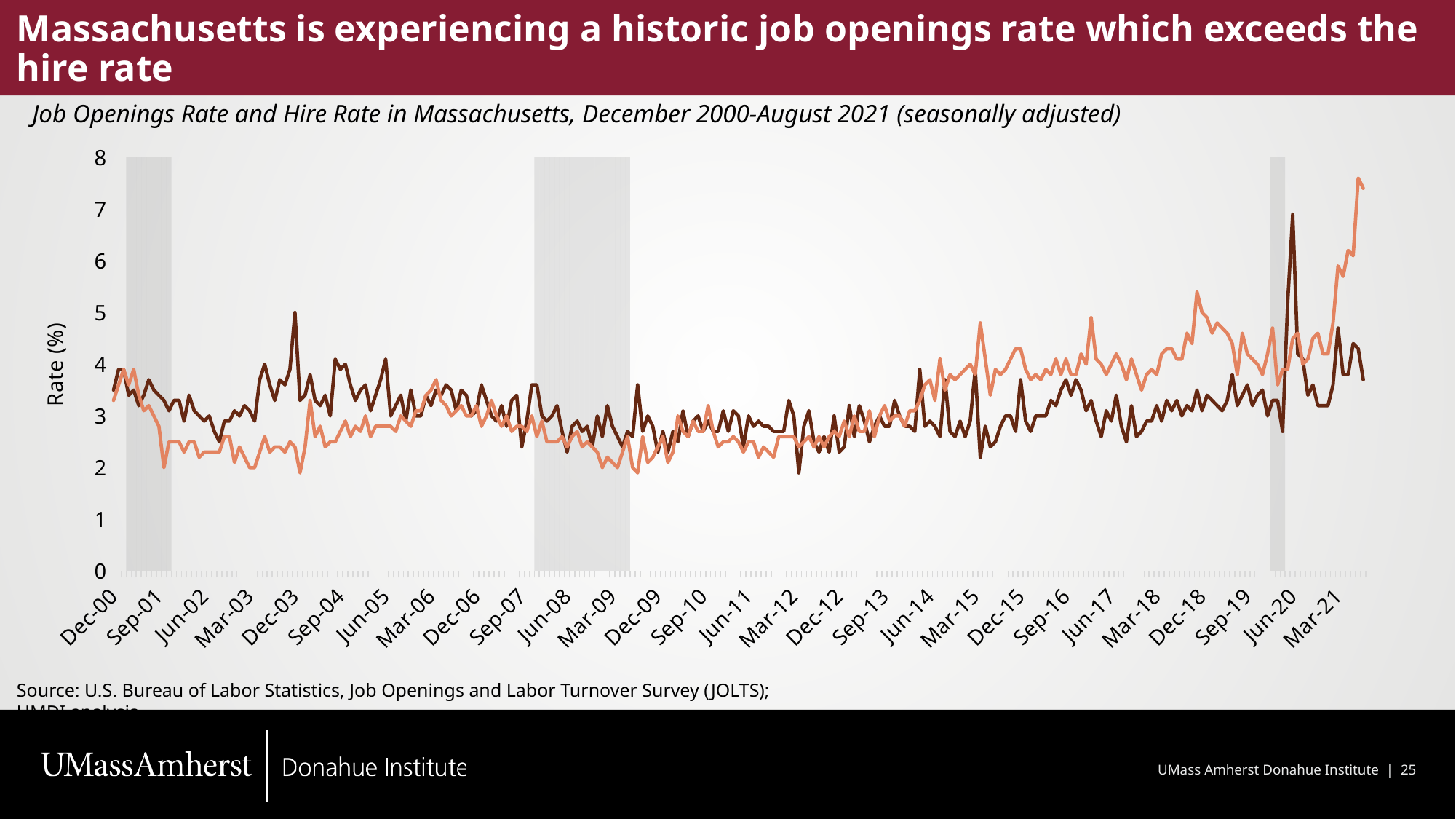
Is the peak value of the orange line, reached near the right end of the chart, greater or less than 7? greater What kind of chart is shown on the slide? Line chart What is the label on the vertical axis of the chart? Rate (%) What is the highest value shown on the vertical axis? 8 Which line is higher at the right end of the chart, the orange line or the dark brown line? The orange line What is the first date label on the horizontal axis? Dec-00 Is the value of the orange line at Dec-00 greater or less than 4? less Is the spike in the dark brown line around Jun-20 greater or less than 6? greater What is the last date label on the horizontal axis? Mar-21 How many lines are plotted on the chart? 2 What is the title of the chart? Job Openings Rate and Hire Rate in Massachusetts, December 2000-August 2021 (seasonally adjusted) Does the orange line generally rise or fall between Dec-09 and the end of the chart? Rise